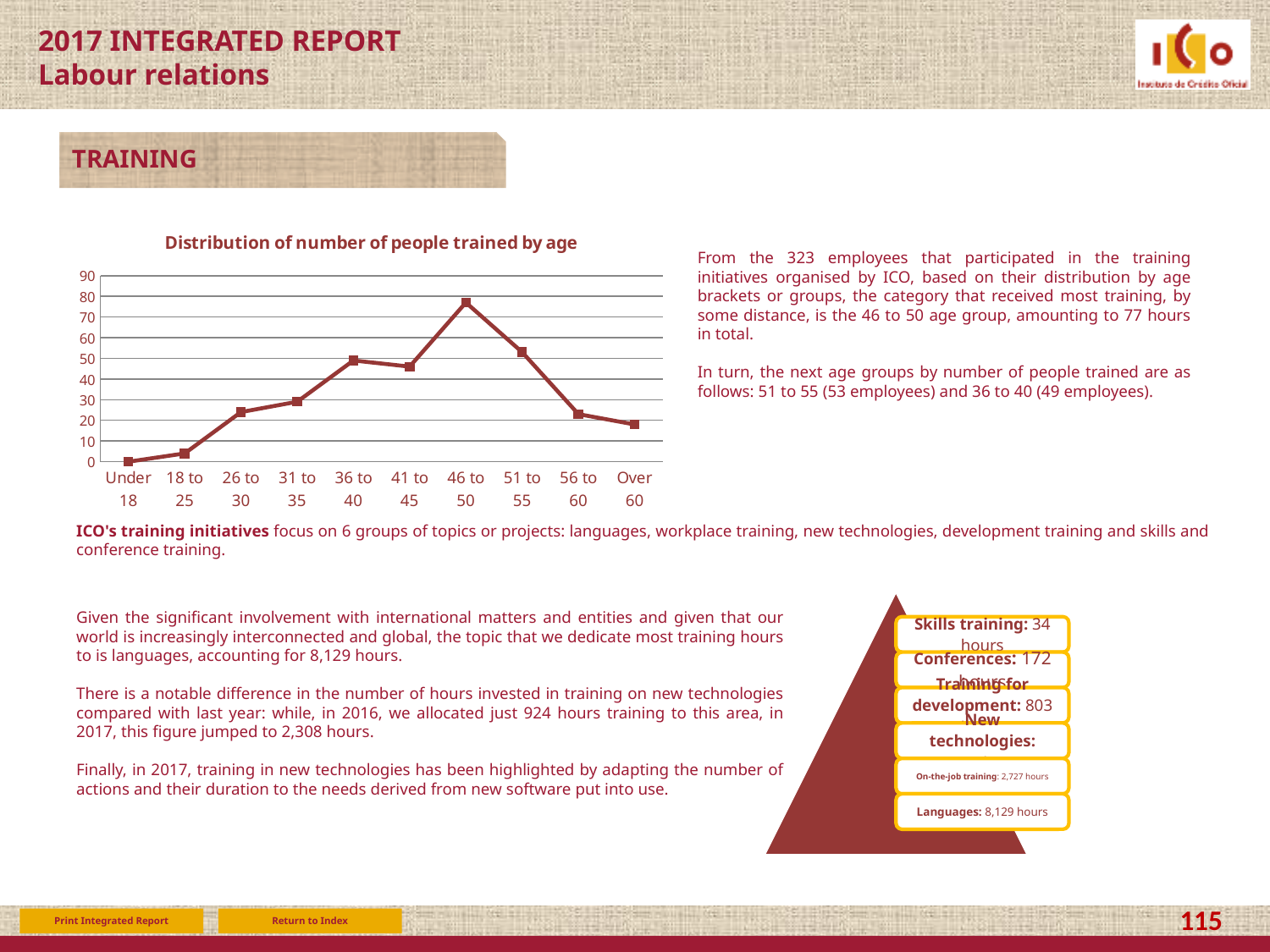
Do the values rise or fall from the 46 to 50 group to the Over 60 group? fall Which has more people trained: the 18 to 25 group or the 31 to 35 group? 31 to 35 Is the value for the 36 to 40 age group greater or less than 40? greater Is the value for the 46 to 50 age group greater or less than 70? greater Is the value for the Over 60 age group greater or less than 30? less What is the title of the chart on the slide? Distribution of number of people trained by age Which age group has the highest number of people trained? 46 to 50 How many age categories are shown on the x axis of the chart? 10 Which age group has the lowest number of people trained? Under 18 What kind of chart is used for 'Distribution of number of people trained by age'? line chart Which has more people trained: the 46 to 50 group or the 51 to 55 group? 46 to 50